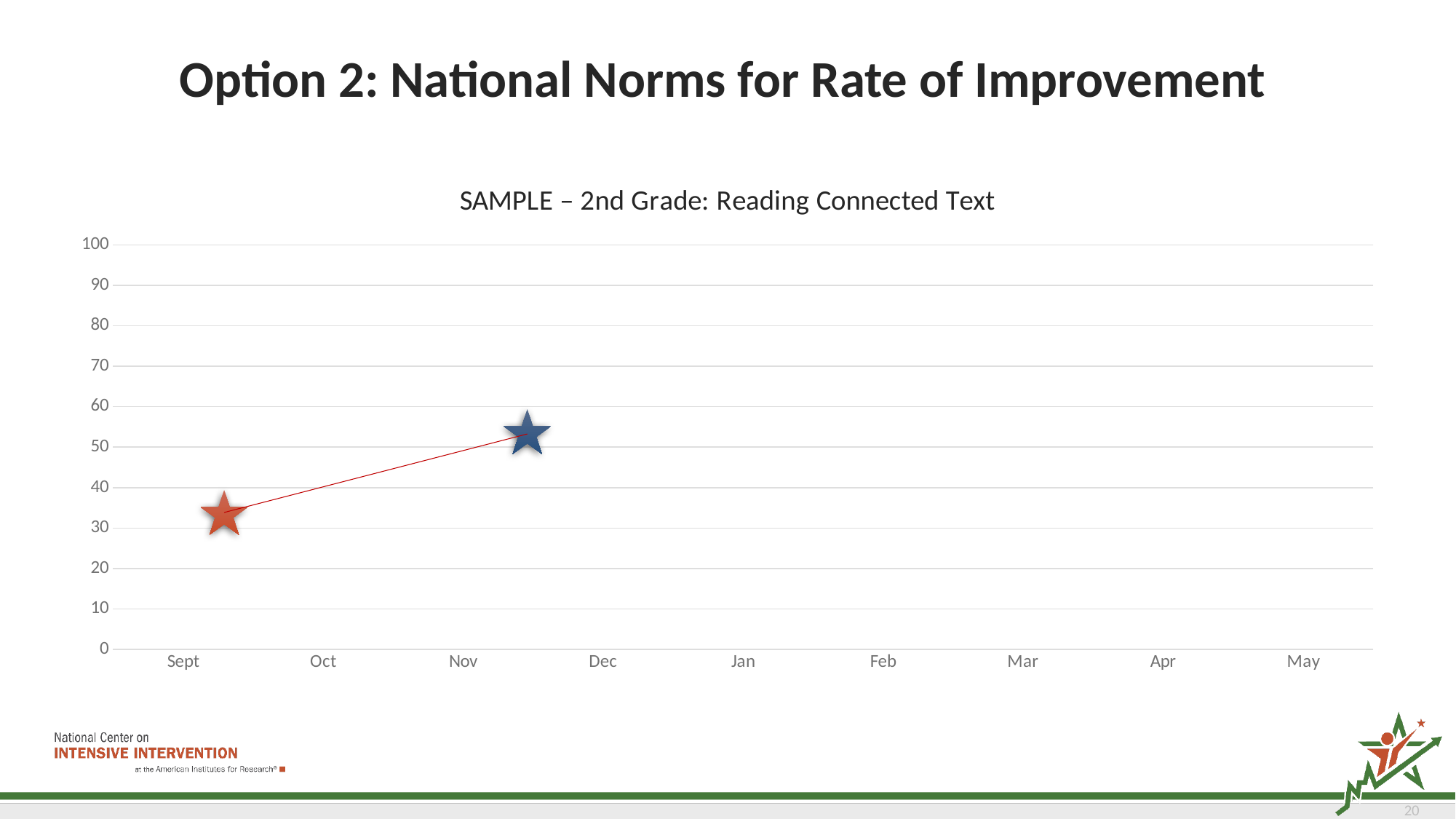
What is the first month label on the x axis? Sept Which star is higher on the chart, the first one near Sept or the second one between Nov and Dec? The second one between Nov and Dec Is the value of the second star (between Nov and Dec) greater or less than 50? greater How many data points (stars) are plotted on the chart? 2 How many month labels are shown on the x axis? 9 What kind of chart is shown on the slide? Line chart Is the value of the first star (near Sept) greater or less than 40? less What is the highest value shown on the y axis? 100 Is the value of the second star (between Nov and Dec) greater or less than 60? less What is the title of the chart? SAMPLE – 2nd Grade: Reading Connected Text Does the line between the two stars rise or fall from left to right? Rise